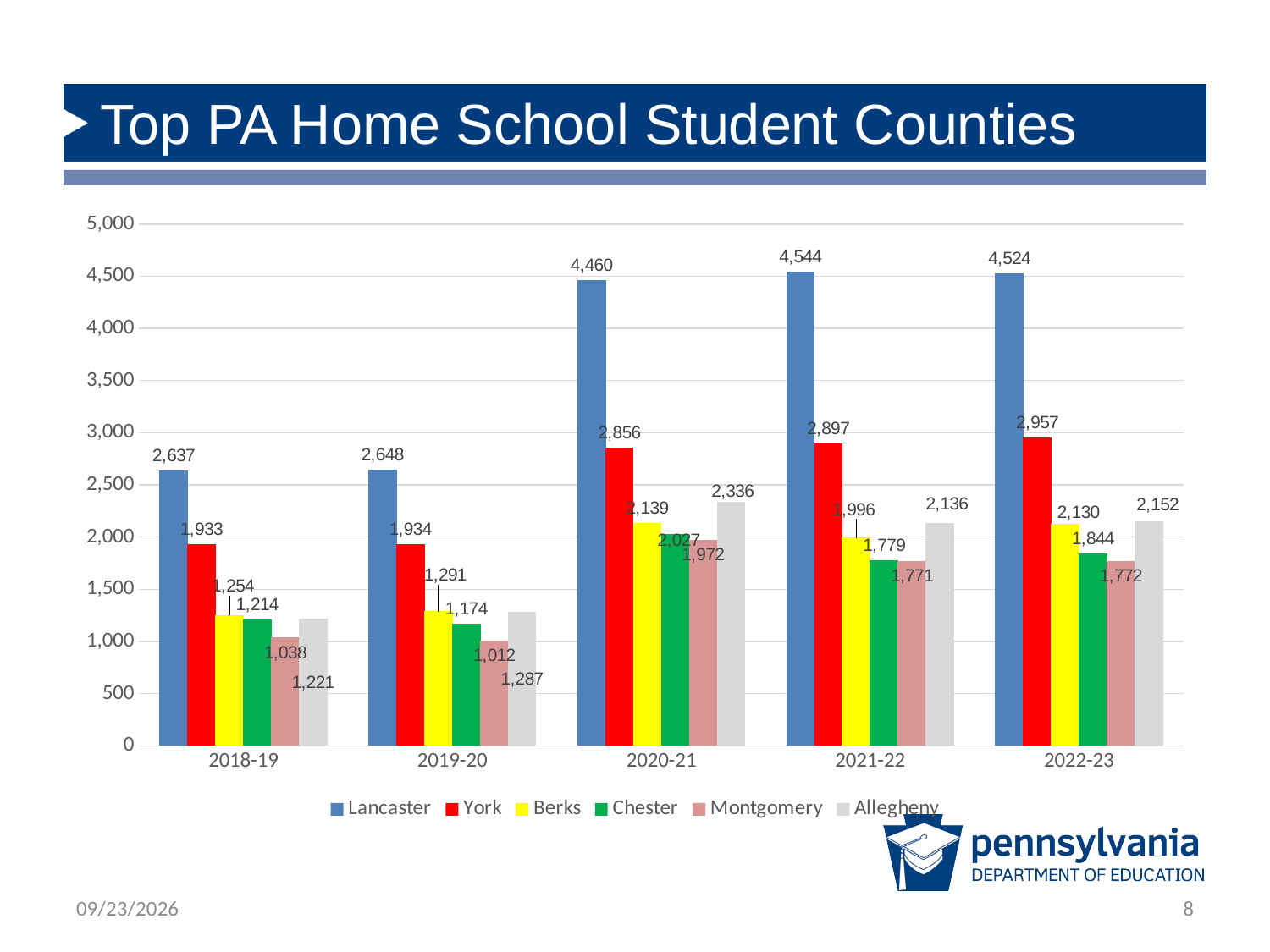
How many year groups are shown on the x axis? 5 In which year does Lancaster have its highest value? 2021-22 Which is larger in 2020-21, Berks or Allegheny? Allegheny What is the value for York in 2022-23? 2,957 What is the value for Montgomery in 2019-20? 1,012 Which county has the lowest value in 2018-19? Montgomery Does the value for York rise or fall from 2018-19 to 2022-23? Rise What is the value for Allegheny in 2021-22? 2,136 What is the value for Lancaster in 2020-21? 4,460 How many series does the legend list? 6 What kind of chart is shown on the slide? Bar chart What is the difference between Lancaster and York in 2021-22? 1,647